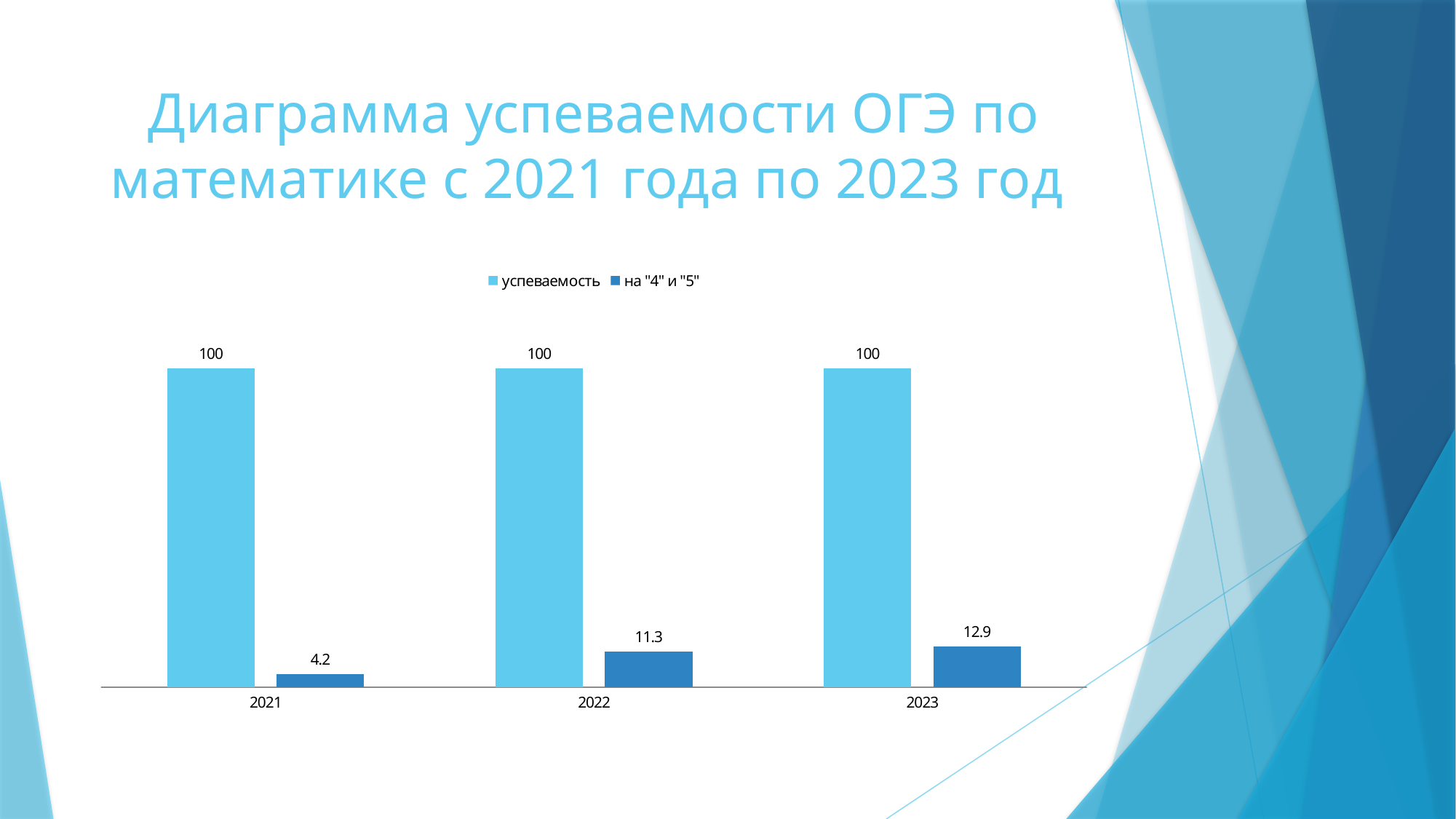
What is the value for "на "4" и "5"" in 2021? 4.2 What is the value for "на "4" и "5"" in 2022? 11.3 How many years are shown on the x axis? 3 Which is larger: the "на "4" и "5"" value for 2022 or for 2023? 2023 What is the value for "успеваемость" in 2022? 100 How many series does the legend list? 2 In which year is the value for "на "4" и "5"" lowest? 2021 What kind of chart is shown on the slide? bar chart What is the value for "на "4" и "5"" in 2023? 12.9 What is the difference between the "на "4" и "5"" values for 2023 and 2021? 8.7 In which year is the value for "на "4" и "5"" highest? 2023 Do the values for "на "4" и "5"" rise or fall from 2021 to 2023? rise